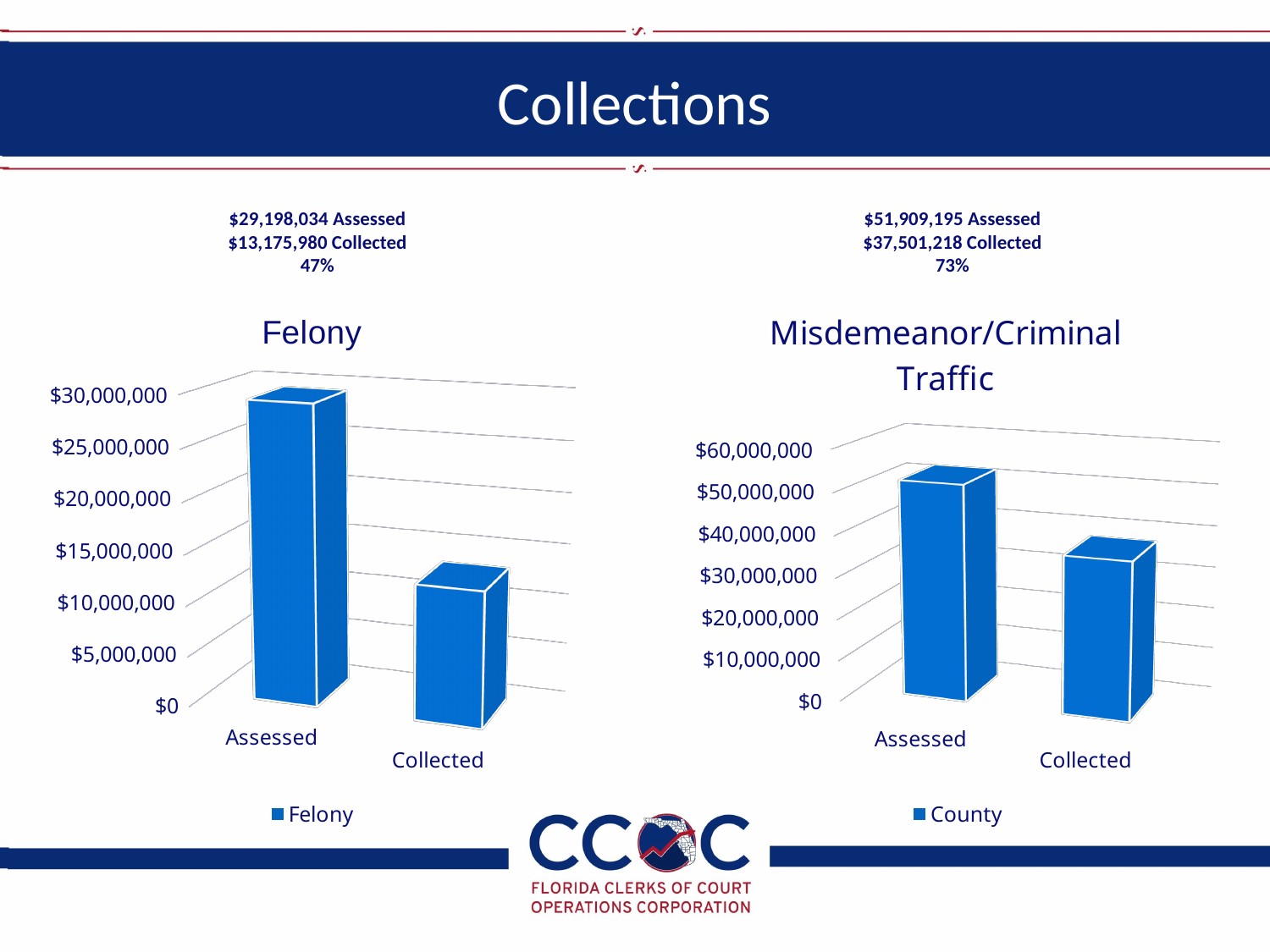
In the Felony chart, what percentage of the assessed amount was collected? 47% In the Felony chart, what is the difference between the Assessed and Collected values? $16,022,054 In the Misdemeanor/Criminal Traffic chart, what is the Assessed value? $51,909,195 In the Felony chart, what is the Collected value? $13,175,980 In the Misdemeanor/Criminal Traffic chart, is the Collected value greater or less than $30,000,000? greater In the Felony chart, what is the Assessed value? $29,198,034 In the Felony chart, which category has the higher bar, Assessed or Collected? Assessed In the Misdemeanor/Criminal Traffic chart, what percentage of the assessed amount was collected? 73% In the Misdemeanor/Criminal Traffic chart, what is the difference between the Assessed and Collected values? $14,407,977 In the Misdemeanor/Criminal Traffic chart, what is the Collected value? $37,501,218 What kind of chart is the Felony chart? bar chart What series name does the legend of the Misdemeanor/Criminal Traffic chart show? County